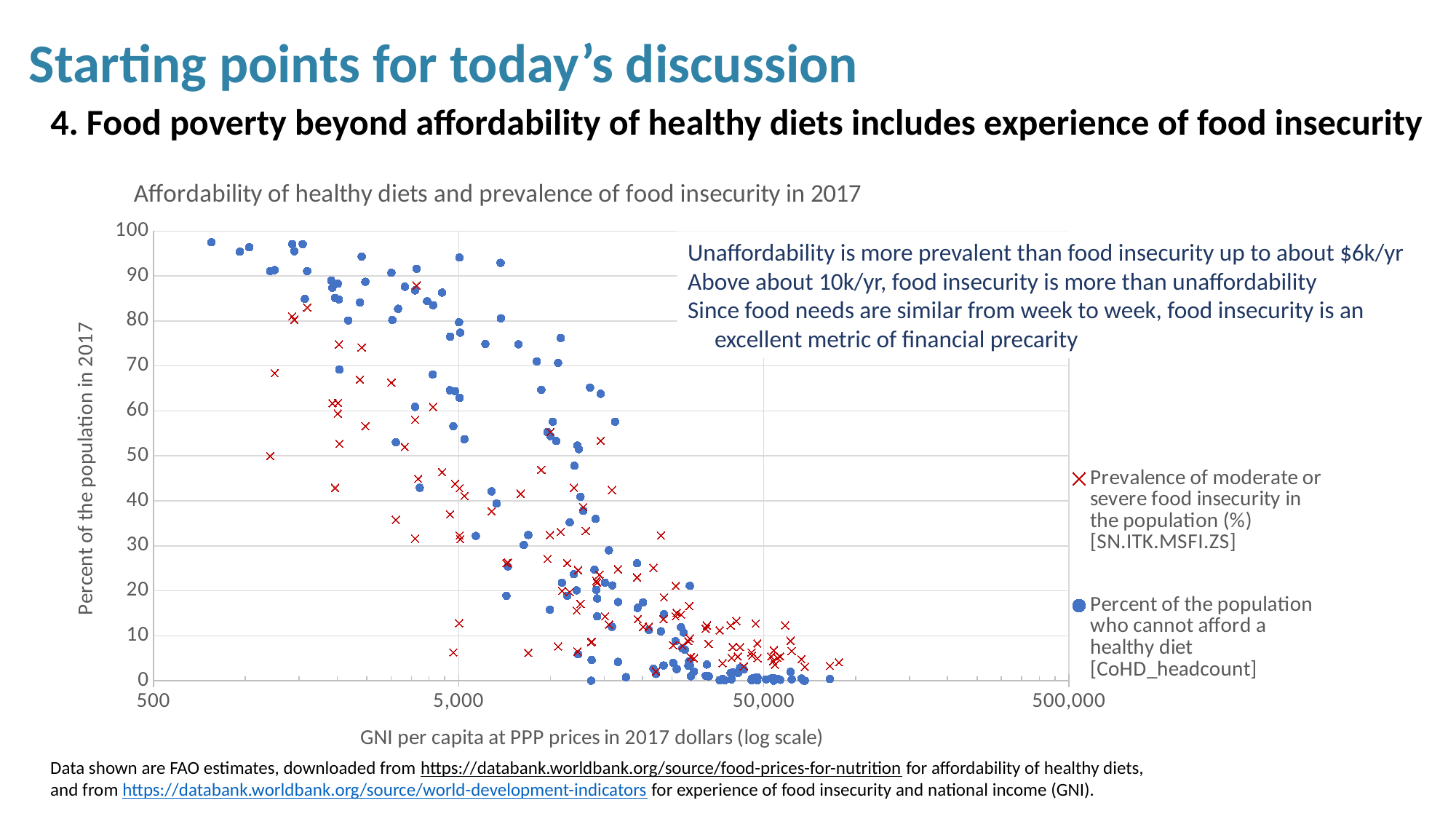
How many series does the chart's legend list? 2 What is the highest value labeled on the y axis? 100 Is the highest plotted value for the blue 'Percent of the population who cannot afford a healthy diet' series greater or less than 90? greater As GNI per capita increases along the x axis, do the plotted values generally rise or fall? Fall What is the title of the chart? Affordability of healthy diets and prevalence of food insecurity in 2017 Are the blue 'cannot afford a healthy diet' values at GNI per capita around 50,000 greater or less than 10? less Which series is plotted with red cross markers? Prevalence of moderate or severe food insecurity in the population (%) [SN.ITK.MSFI.ZS] How many labeled tick values are shown on the x axis? 4 What kind of chart is shown on the slide? Scatter chart What is the highest value labeled on the x axis? 500,000 Is the highest plotted value for the red 'Prevalence of moderate or severe food insecurity' series greater or less than 80? greater